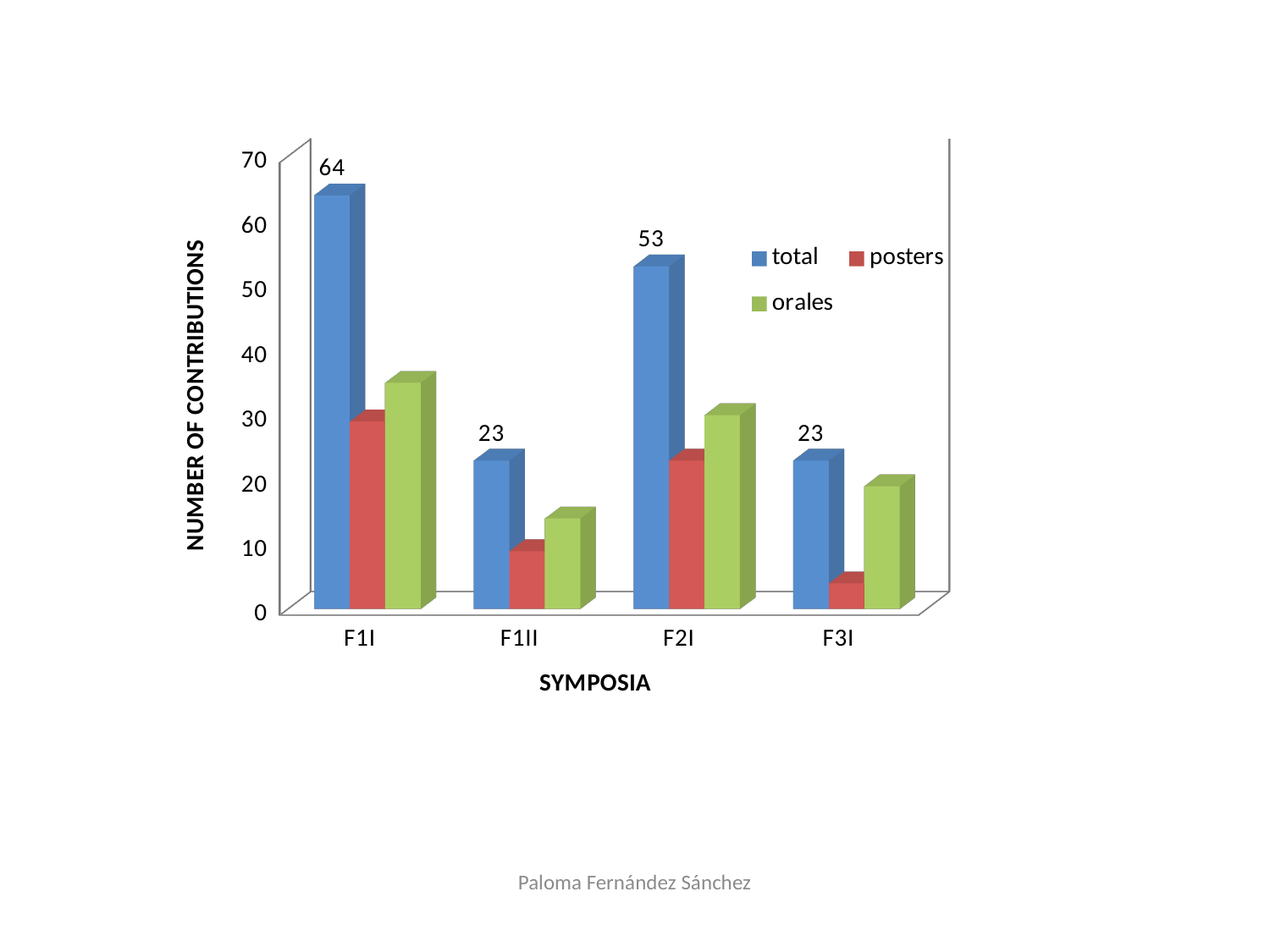
How many symposia are shown on the x axis? 4 What is the difference between the total contributions for F1I and F2I? 11 Is the orales value for F1II greater or less than 20? less Which has a larger total number of contributions, F1II or F2I? F2I What is the total number of contributions for F1I? 64 Which symposium has the highest total number of contributions? F1I What is the total number of contributions for F3I? 23 Is the orales value for F1I greater or less than 30? greater Is the posters value for F3I greater or less than 10? less How many series does the legend list? 3 What kind of chart is shown on the slide? bar chart What is the total number of contributions for F2I? 53